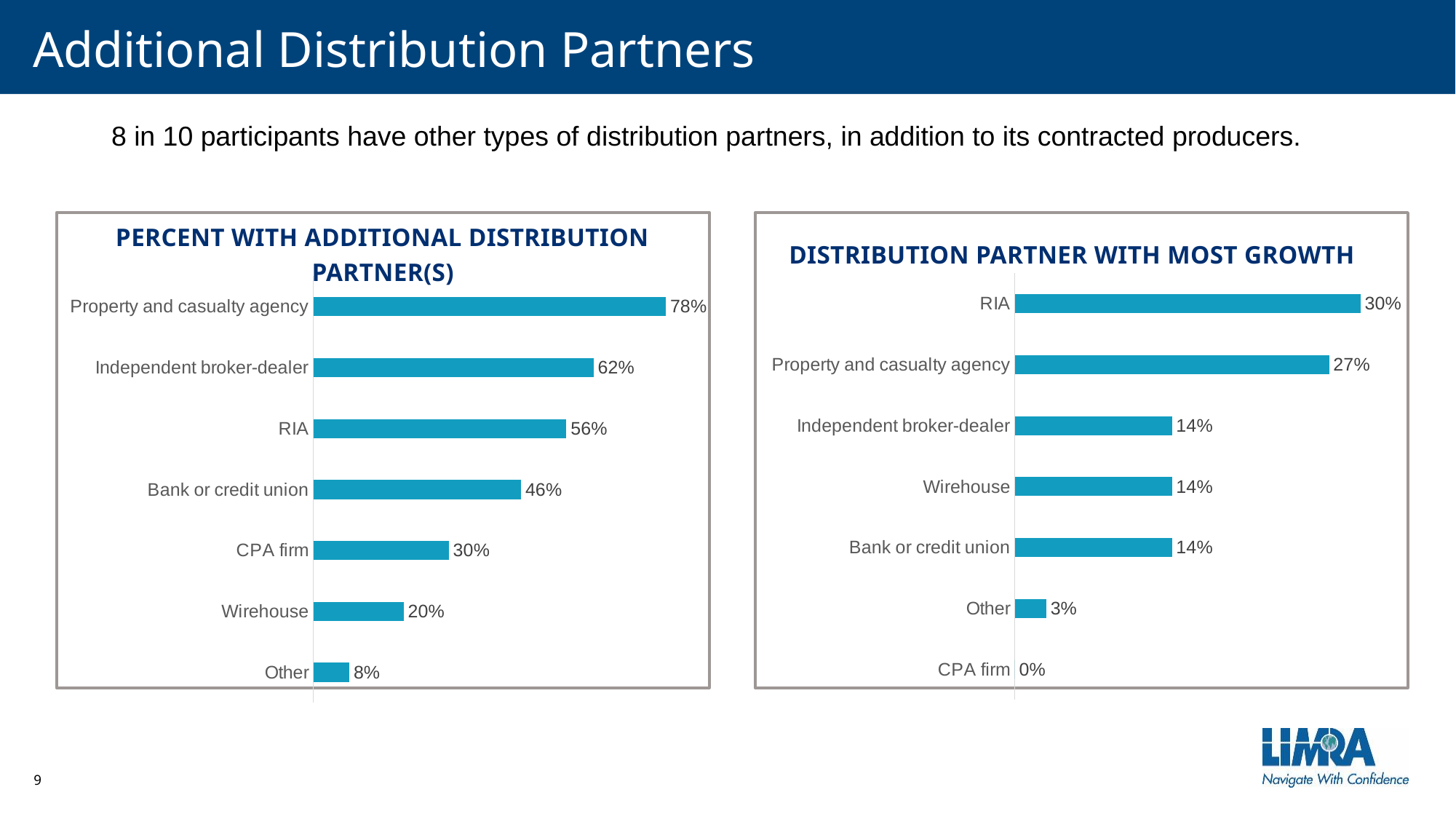
In the 'Distribution Partner with Most Growth' chart, what is the difference between RIA and Independent broker-dealer? 16% In the 'Percent with Additional Distribution Partner(s)' chart, which is larger: CPA firm or Wirehouse? CPA firm In the 'Percent with Additional Distribution Partner(s)' chart, what is the difference between RIA and Bank or credit union? 10% In the 'Distribution Partner with Most Growth' chart, what is the value for Other? 3% In the 'Distribution Partner with Most Growth' chart, what is the value for Property and casualty agency? 27% What type of chart is the 'Distribution Partner with Most Growth' chart? Bar chart In the 'Percent with Additional Distribution Partner(s)' chart, which category has the lowest value? Other In the 'Distribution Partner with Most Growth' chart, which category has the highest value? RIA In the 'Percent with Additional Distribution Partner(s)' chart, how many categories are shown? 7 In the 'Distribution Partner with Most Growth' chart, which category has the lowest value? CPA firm In the 'Percent with Additional Distribution Partner(s)' chart, which category has the highest value? Property and casualty agency In the 'Percent with Additional Distribution Partner(s)' chart, what is the value for Independent broker-dealer? 62%